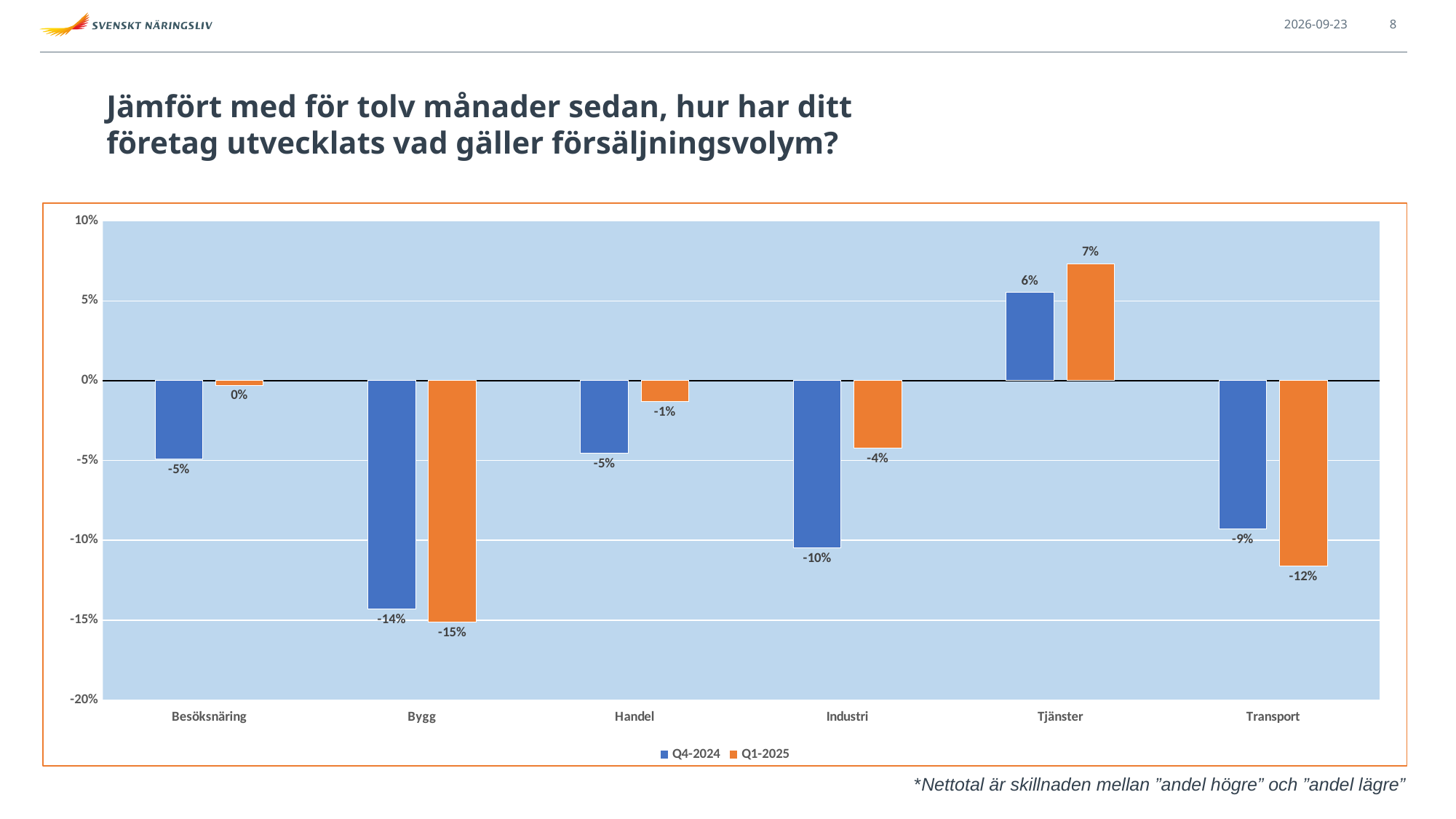
Which colour represents the Q1-2025 series? Orange What is the Q1-2025 value for Industri? -4% How many series does the legend list? 2 Which category has the lowest Q4-2024 value? Bygg What is the Q4-2024 value for Bygg? -14% What is the difference between the Q1-2025 and Q4-2024 values for Industri? 6 percentage points Which category has the highest Q1-2025 value? Tjänster Which is larger for Handel, the Q4-2024 value or the Q1-2025 value? Q1-2025 What is the Q1-2025 value for Transport? -12% What kind of chart is shown on the slide? Bar chart How many categories are shown on the x axis? 6 What is the Q4-2024 value for Tjänster? 6%